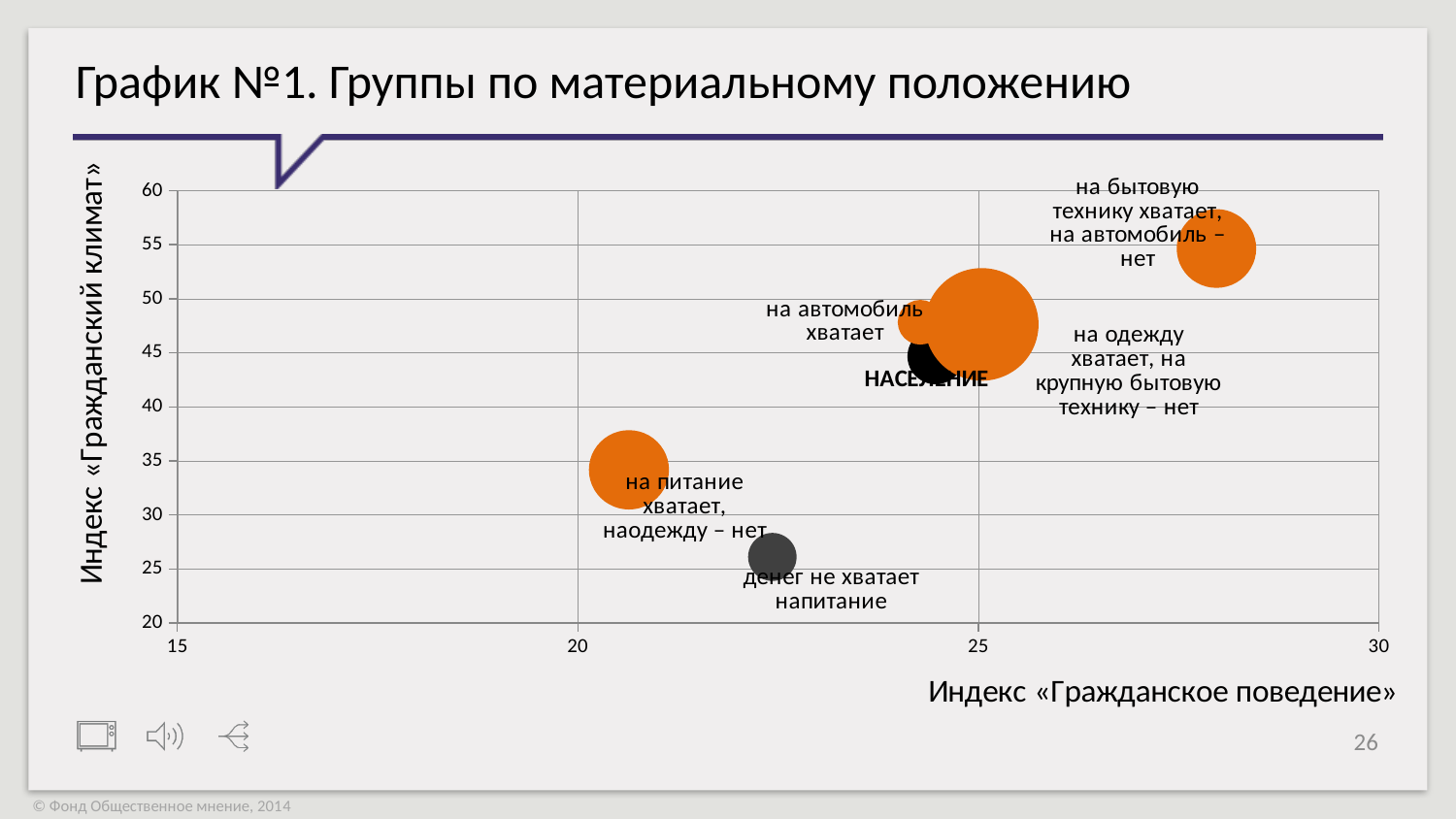
Which group has the highest value on the vertical axis (Индекс «Гражданский климат»)? на бытовую технику хватает, на автомобиль – нет Which group has the highest value on the horizontal axis (Индекс «Гражданское поведение»)? на бытовую технику хватает, на автомобиль – нет What is the title of the chart? График №1. Группы по материальному положению Which group has the lowest value on the horizontal axis (Индекс «Гражданское поведение»)? на питание хватает, на одежду – нет Is the vertical-axis value for the group «денег не хватает на питание» greater or less than 30? less Is the vertical-axis value for the group «на бытовую технику хватает, на автомобиль – нет» greater or less than 50? greater Is the vertical-axis value for «НАСЕЛЕНИЕ» greater or less than 50? less Which group has the lowest value on the vertical axis (Индекс «Гражданский климат»)? денег не хватает на питание What kind of chart is shown on the slide? bubble chart Which has a higher vertical-axis value: «на питание хватает, на одежду – нет» or «денег не хватает на питание»? на питание хватает, на одежду – нет What is the label of the horizontal axis? Индекс «Гражданское поведение»